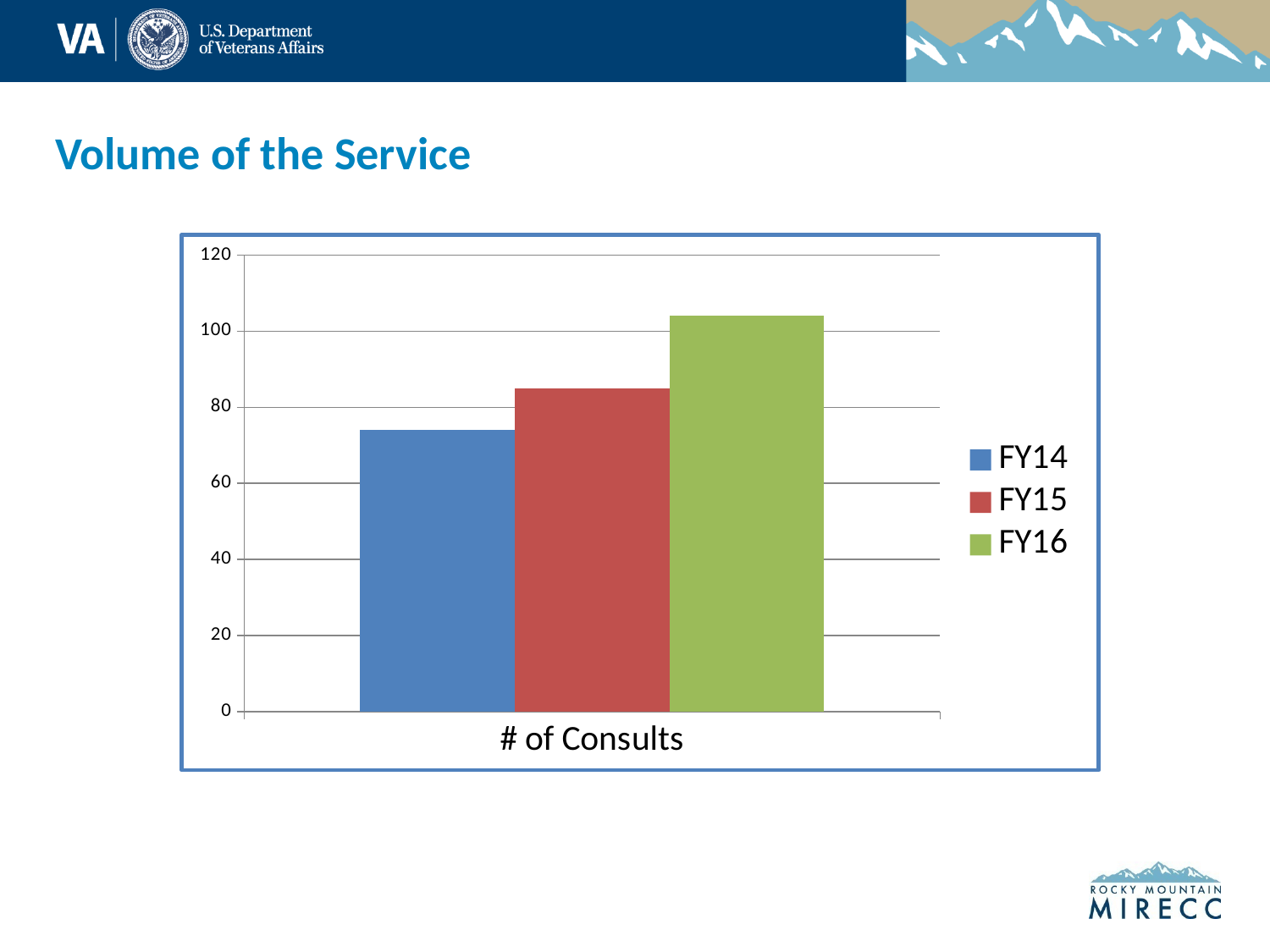
What kind of chart is shown on the slide? bar chart How many series does the legend list? 3 Is the value for FY15 greater or less than 100? less Is the value for FY16 greater or less than 100? greater What colour is the bar for FY16? green Is the value for FY14 greater or less than 80? less What is the category label shown on the x axis? # of Consults Which fiscal year has the lowest number of consults? FY14 Do the number of consults rise or fall from FY14 to FY16? rise Which is larger, the number of consults for FY15 or FY14? FY15 Which fiscal year has the highest number of consults? FY16